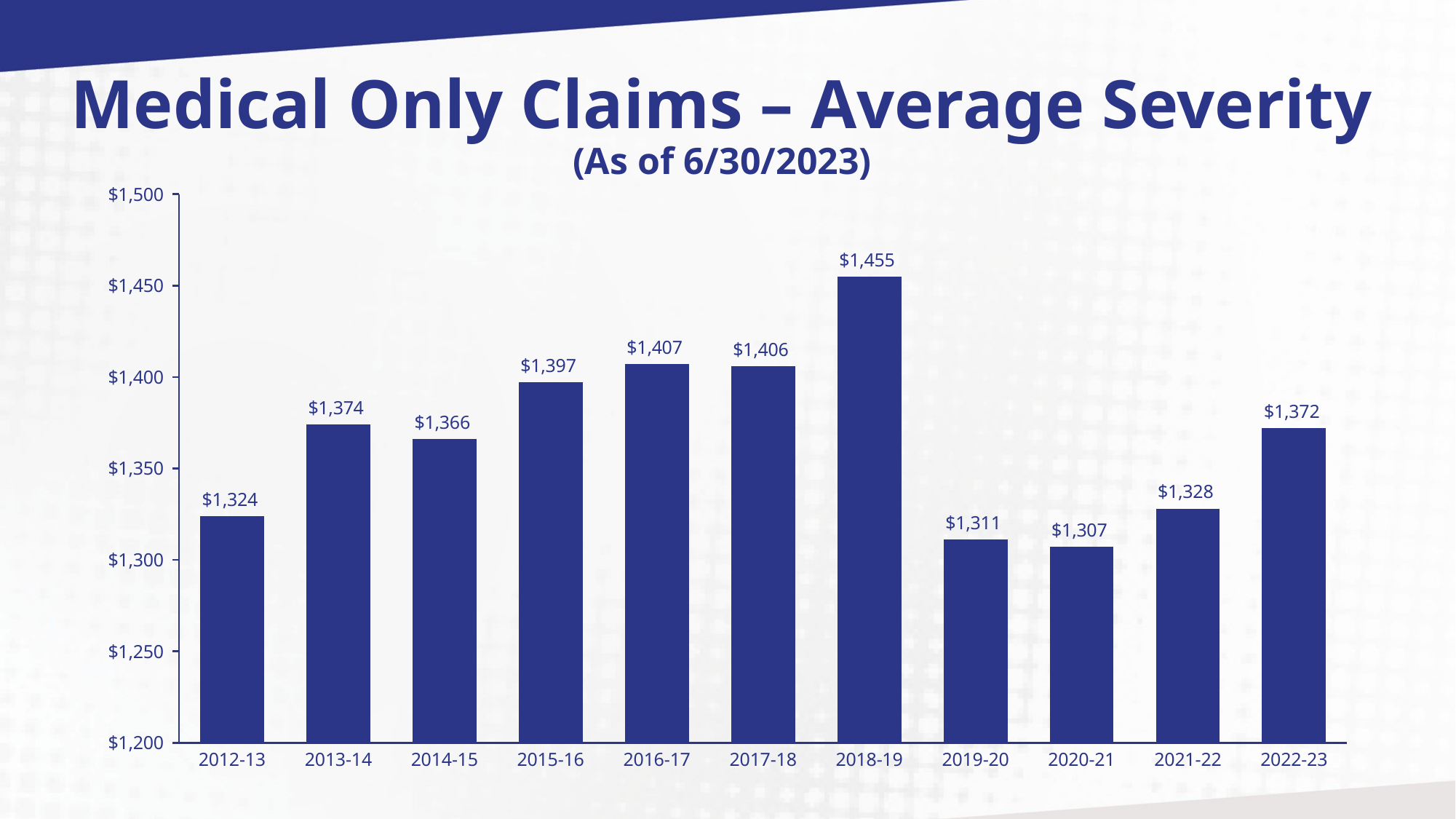
What is the average severity for 2018-19? $1,455 Which is larger, the average severity for 2013-14 or for 2014-15? 2013-14 What is the difference between the average severity in 2022-23 and 2021-22? $44 What is the title of the chart? Medical Only Claims – Average Severity Which fiscal year has the highest average severity? 2018-19 Is the value for 2015-16 greater or less than $1,400? less Which fiscal year has the lowest average severity? 2020-21 What is the average severity for 2022-23? $1,372 What is the difference between the average severity in 2018-19 and 2019-20? $144 How many fiscal years are shown on the chart? 11 What kind of chart is shown on the slide? bar chart What is the average severity for 2012-13? $1,324